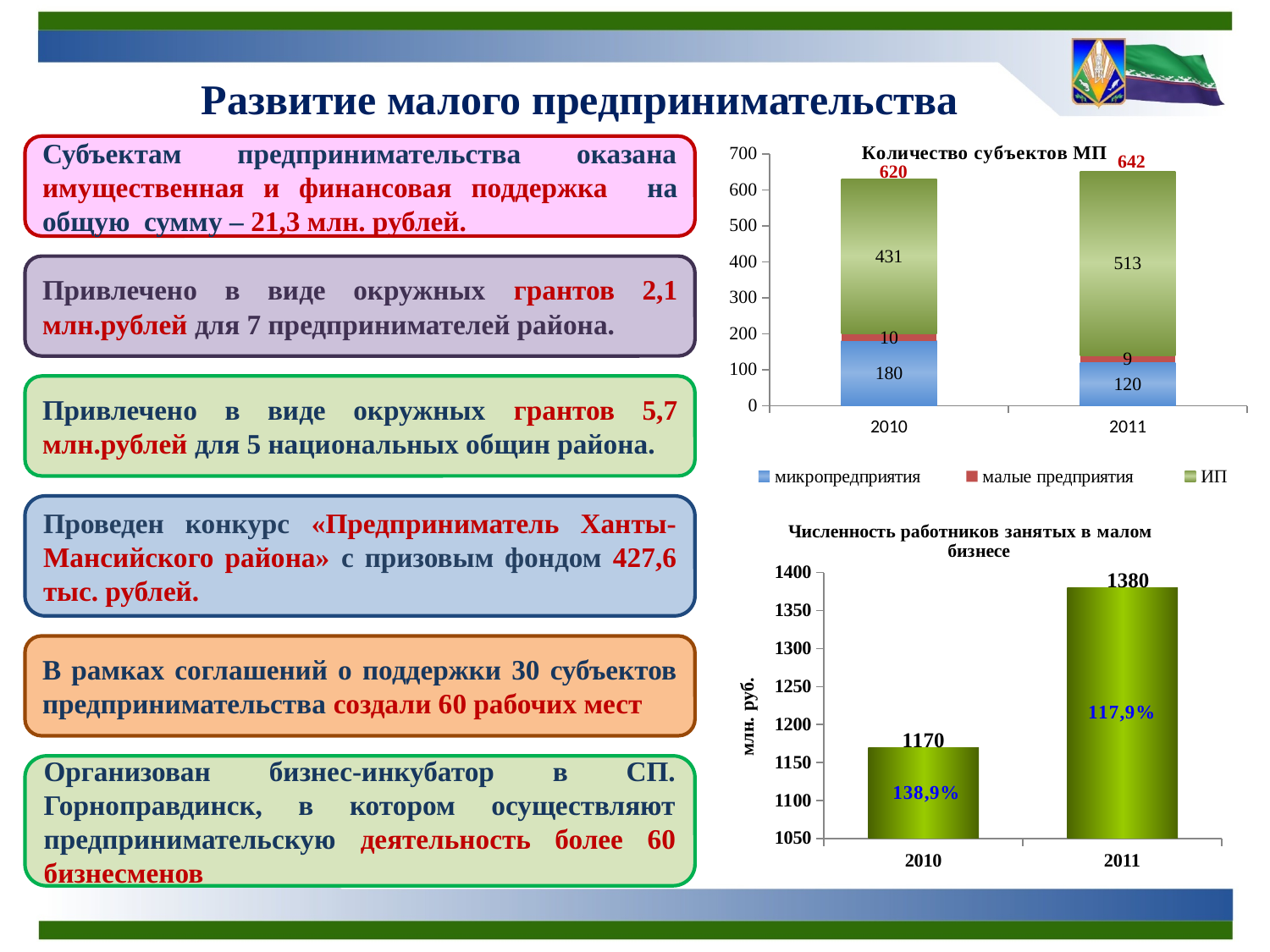
In the chart 'Численность работников занятых в малом бизнесе', what is the value for 2011? 1380 In the chart 'Количество субъектов МП', how many series does the legend list? 3 In the chart 'Количество субъектов МП', what is the total shown above the stacked bar for 2011? 642 In the chart 'Количество субъектов МП', what is the value for малые предприятия in 2011? 9 In the chart 'Численность работников занятых в малом бизнесе', what kind of chart is shown? bar chart In the chart 'Количество субъектов МП', what is the value for ИП in 2011? 513 In the chart 'Количество субъектов МП', which year has the larger value for микропредприятия, 2010 or 2011? 2010 In the chart 'Численность работников занятых в малом бизнесе', what is the difference between the 2011 and 2010 values? 210 In the chart 'Количество субъектов МП', what is the total shown above the stacked bar for 2010? 620 In the chart 'Количество субъектов МП', what is the difference between the ИП values for 2011 and 2010? 82 In the chart 'Численность работников занятых в малом бизнесе', do the values rise or fall from 2010 to 2011? rise In the chart 'Количество субъектов МП', what is the value for микропредприятия in 2010? 180